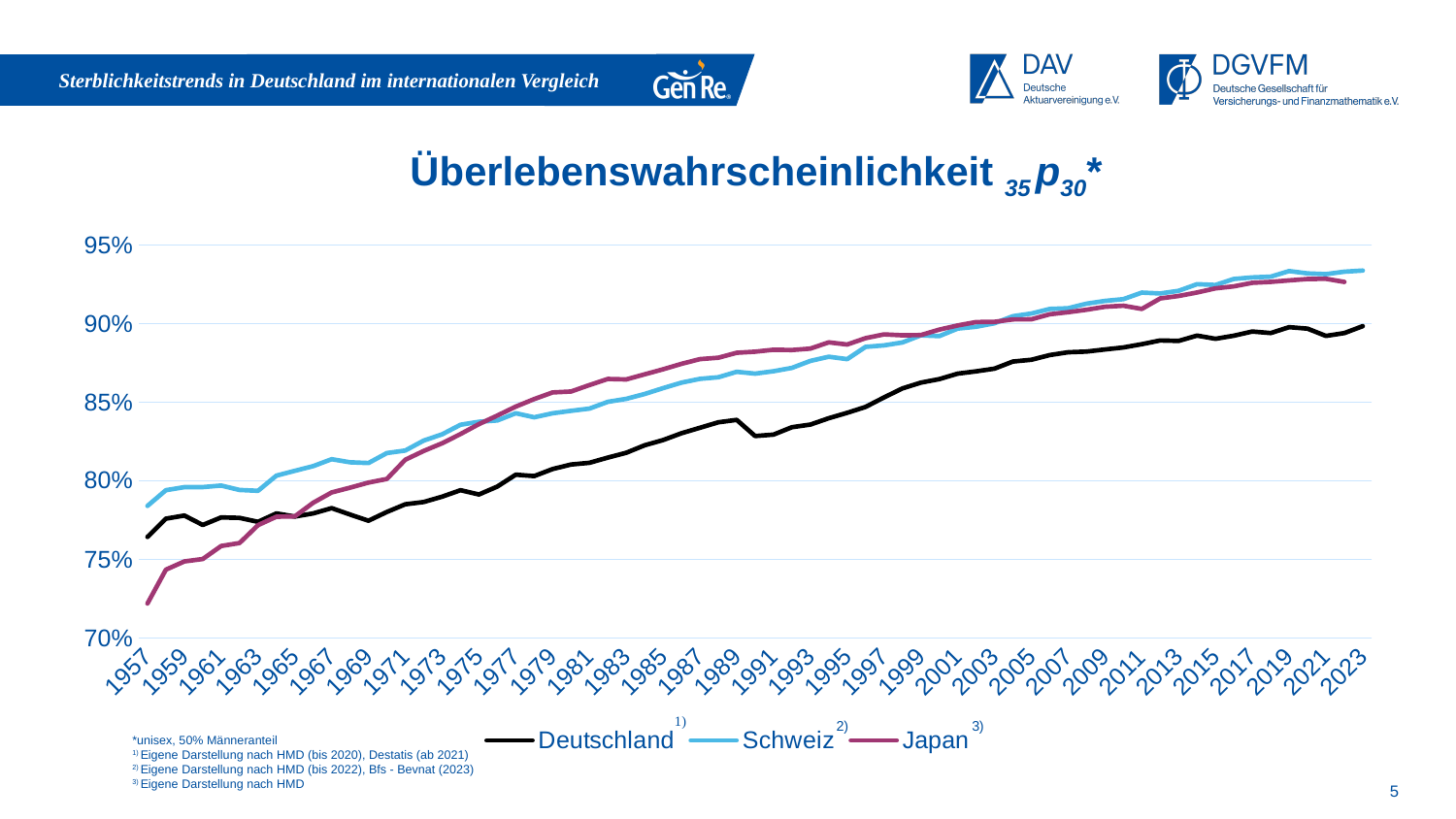
Which series has the lowest value in 2023? Deutschland Is the value for Japan in 1957 greater or less than 75%? less Which three countries are shown in the legend? Deutschland, Schweiz, Japan What kind of chart is shown on the slide? line chart Does the value for Schweiz rise or fall from 1957 to 2023? rise In 2023, which is higher: Deutschland or Schweiz? Schweiz Is the value for Schweiz in 2023 greater or less than 90%? greater How many series does the legend list? 3 What is the title of the chart? Überlebenswahrscheinlichkeit 35p30* Is the value for Deutschland in 1957 greater or less than 75%? greater Which series has the lowest value in 1957? Japan